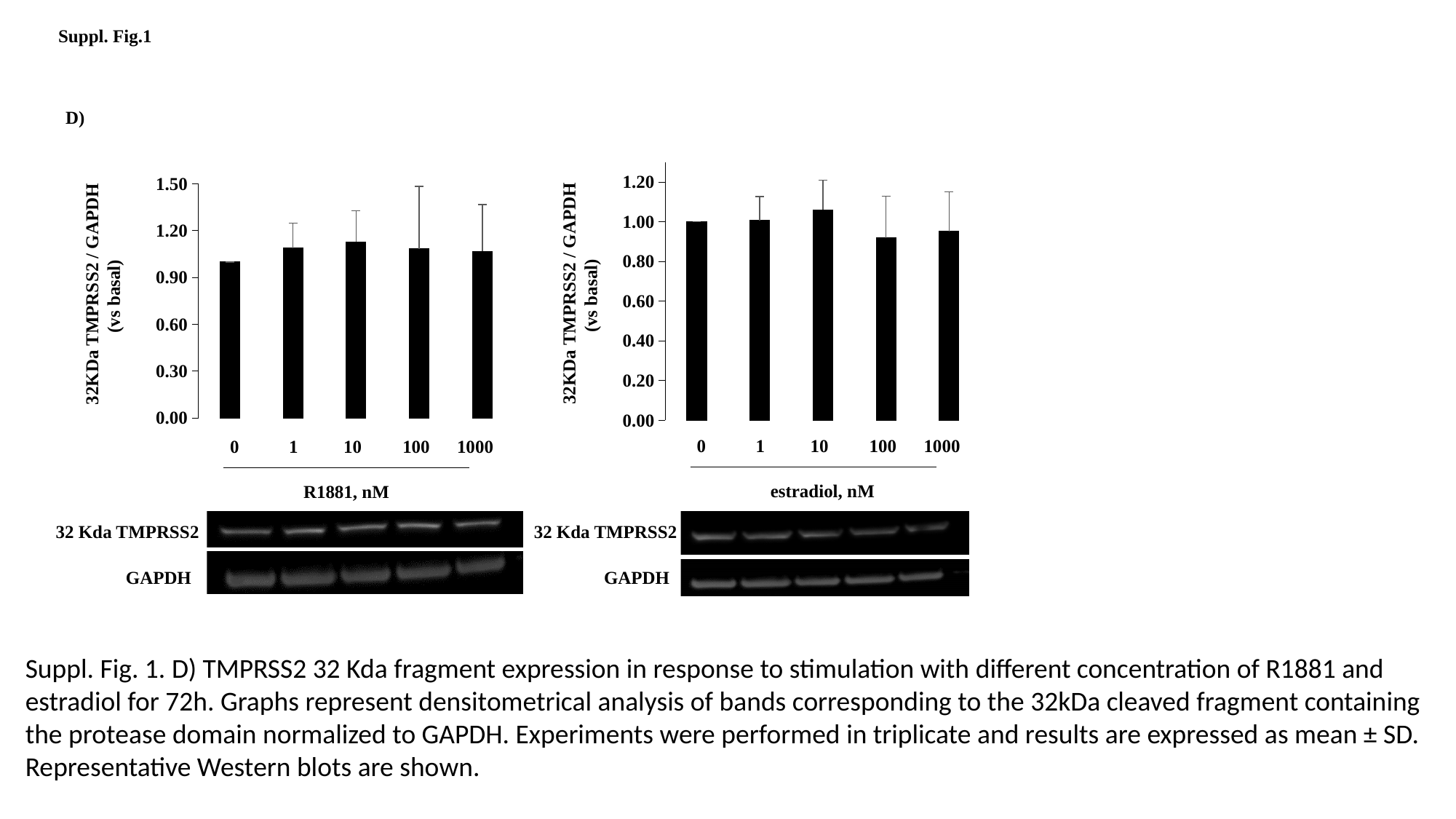
In the left chart (R1881, nM), which concentration has the lowest bar? 0 What is the x-axis label of the right chart? estradiol, nM How many bars are shown in the left chart (R1881, nM)? 5 How many concentration categories are plotted in the right chart (estradiol, nM)? 5 In the left chart (R1881, nM), is the value for 10 nM greater or less than 1.20? less In the right chart (estradiol, nM), which is larger, the value for 10 nM or the value for 100 nM? 10 nM In the right chart (estradiol, nM), what is the value for 0 nM? 1.00 What kind of chart is the left chart (R1881, nM)? bar chart What is the x-axis label of the left chart? R1881, nM In the left chart (R1881, nM), is the value for 0 nM greater or less than 0.90? greater In the right chart (estradiol, nM), is the value for 100 nM greater or less than 1.00? less